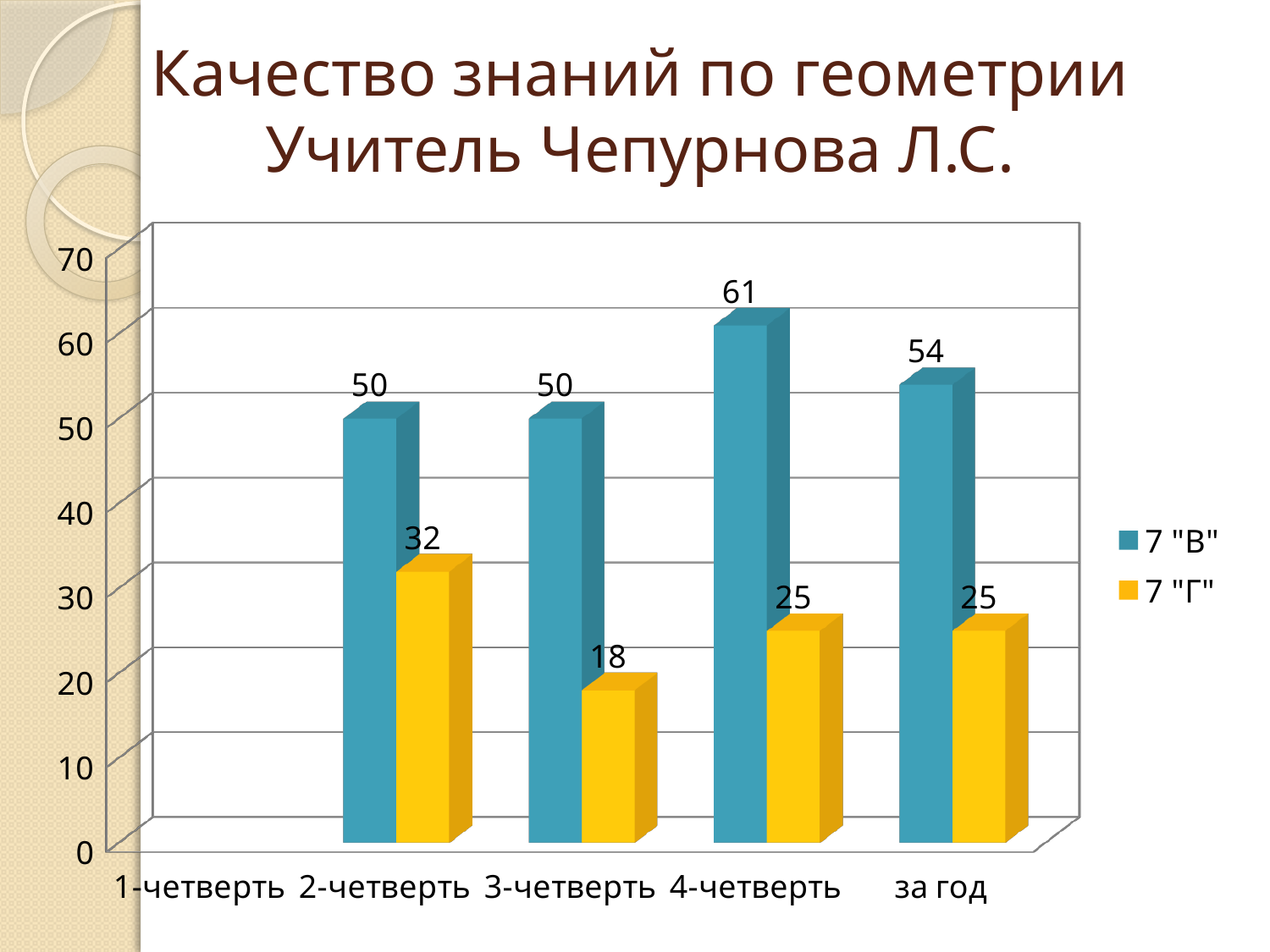
Which is larger in 2-четверть: 7 "В" or 7 "Г"? 7 "В" Which colour represents the series 7 "Г"? Yellow What is the difference between 7 "В" and 7 "Г" in 3-четверть? 32 What is the value for 7 "В" in 4-четверть? 61 What is the value for 7 "Г" in 2-четверть? 32 How many series does the legend list? 2 What is the value for 7 "В" for за год? 54 What kind of chart is shown on the slide? Bar chart What is the value for 7 "Г" in 3-четверть? 18 In which category does 7 "Г" have its lowest value? 3-четверть How many category labels are shown on the x axis? 5 In which category does 7 "В" reach its highest value? 4-четверть